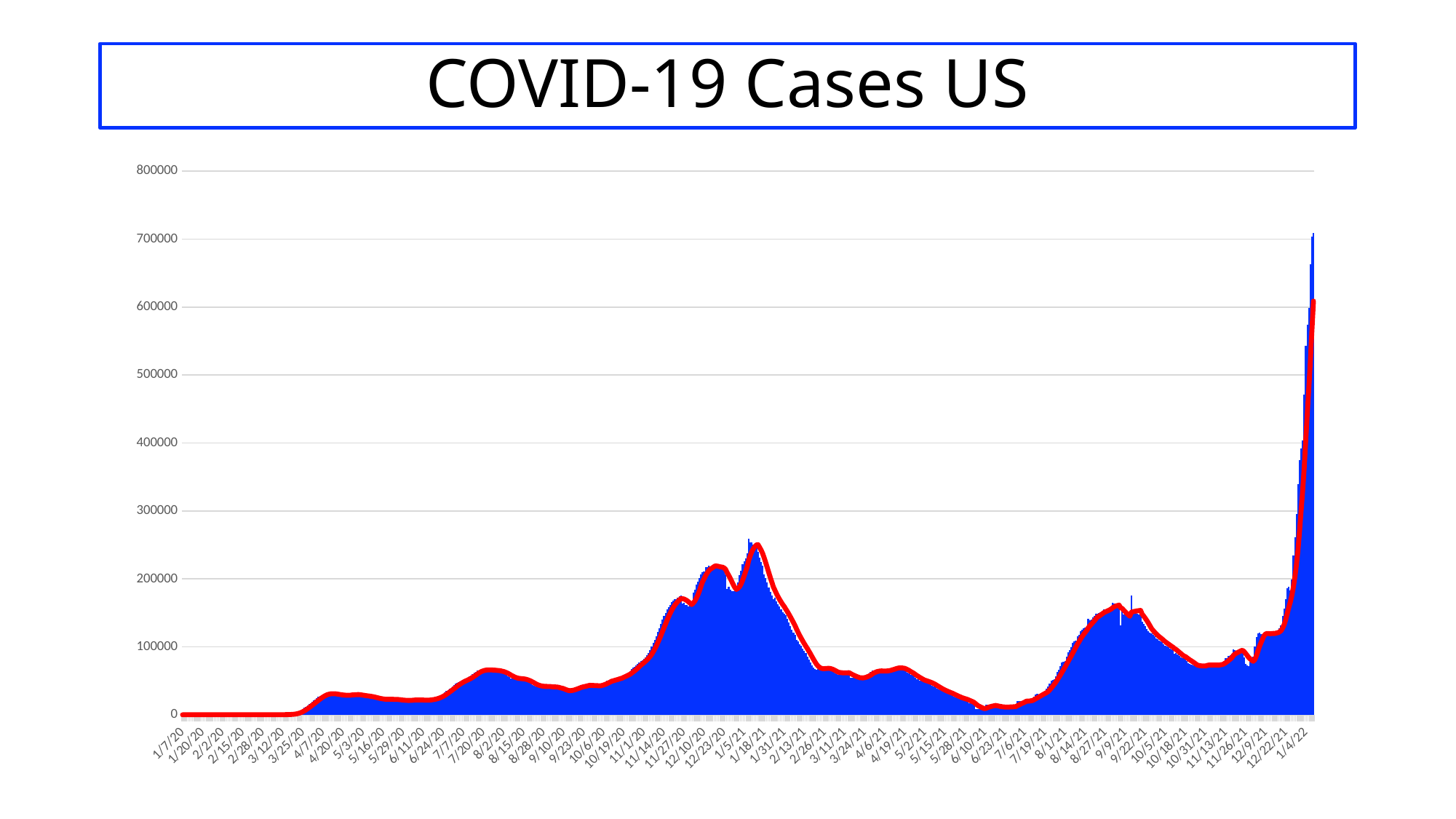
Do the values rise or fall between 11/26/21 and 1/4/22? Rise Is the value around 1/18/21 greater or less than 200000? greater What is the title of the chart? COVID-19 Cases US Which is larger, the peak around 1/18/21 or the peak around 8/27/21? The peak around 1/18/21 What kind of chart is shown on the slide? Bar chart with a line overlay Is the highest value at the right end of the chart greater or less than 500000? greater Around which date on the x axis does the chart reach its highest value? 1/4/22 Is the value around 8/27/21 greater or less than 200000? less Do the values rise or fall between 1/18/21 and 6/10/21? Fall What colour is the line drawn over the bars? Red